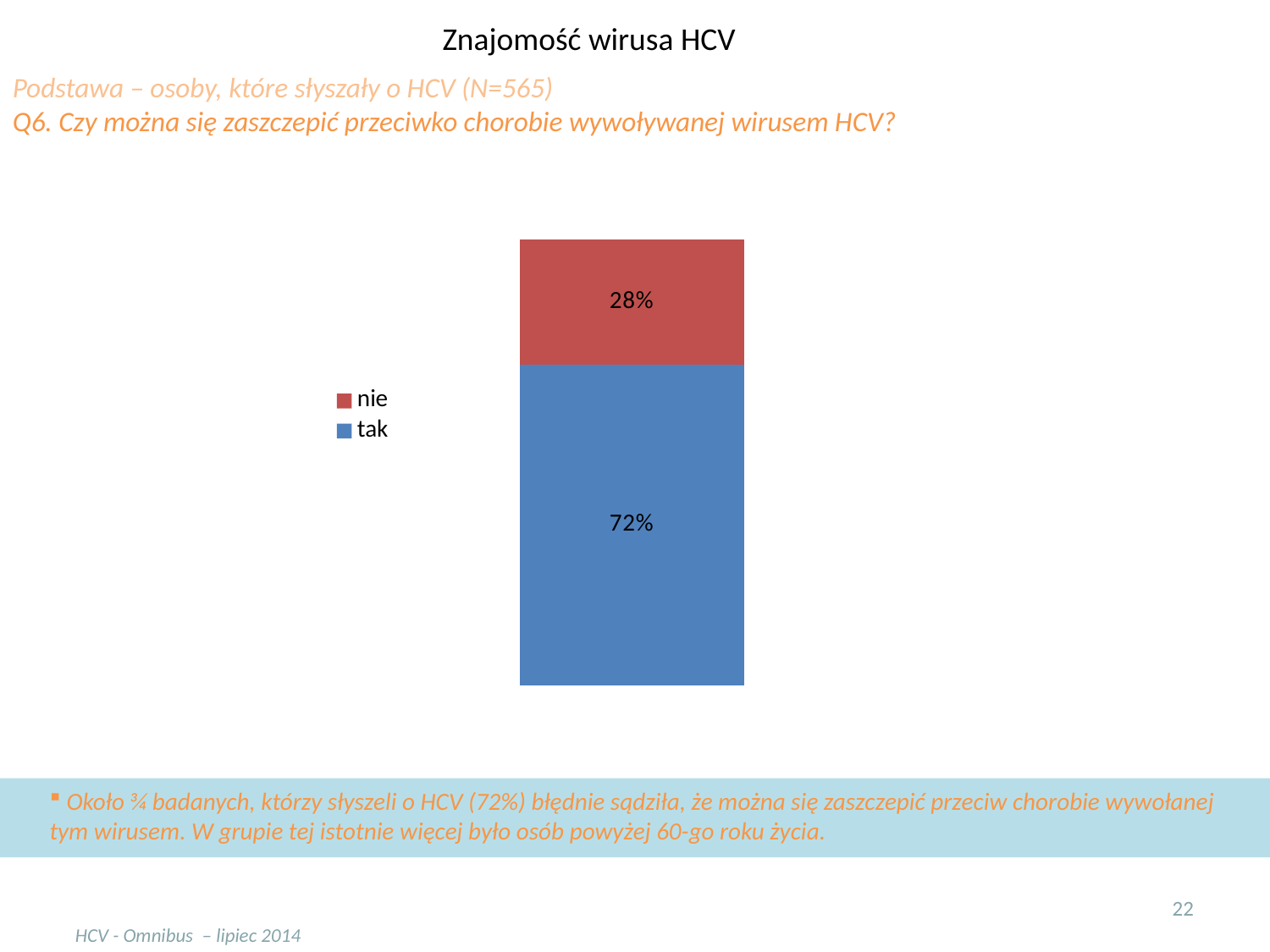
Which colour represents the "nie" response in the chart? red What percentage of respondents answered "nie"? 28% What is the difference in percentage points between "tak" and "nie"? 44 Which response has the smallest share? nie How many series does the legend list? 2 What percentage of respondents answered "tak"? 72% Which response has the larger share, "tak" or "nie"? tak Which colour represents the "tak" response in the chart? blue Is the value for "tak" greater or less than 50%? greater What kind of chart is shown on the slide? stacked bar chart What is the total of the two segments in the stacked bar? 100%